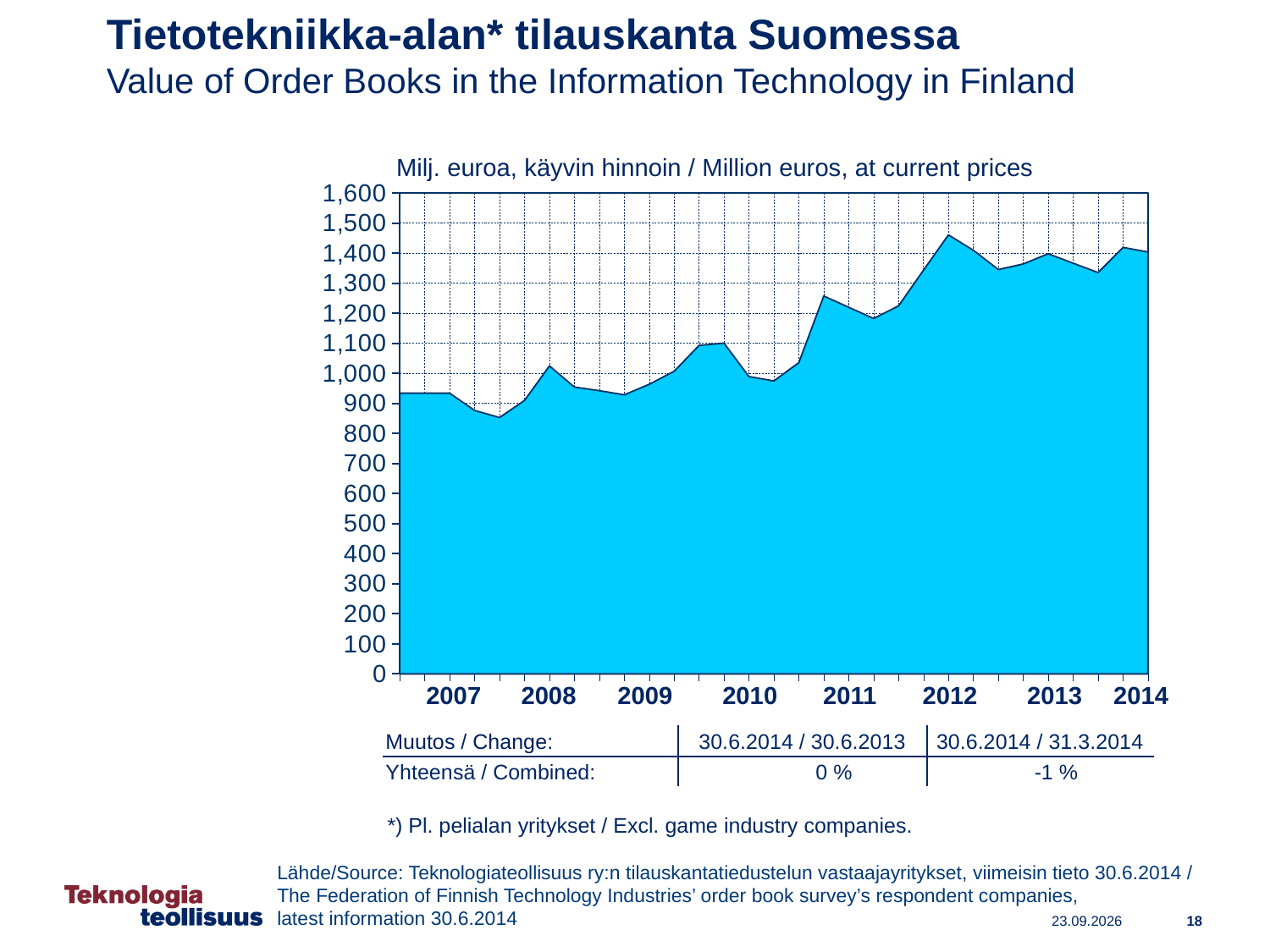
How many years are labelled on the x axis of the chart? 8 Is the lowest value in the chart, reached in late 2007, greater or less than 900? less What kind of chart is shown on the slide? area chart Is the value at the start of 2013 greater or less than 1,300? greater Is the value in 2012 higher or lower than the value in 2007? higher Which year is the first labelled on the x axis? 2007 Is the value at the start of 2010 greater or less than 900? greater What is the highest value shown on the y axis of the chart? 1,600 Overall, do the values rise or fall from 2007 to 2014? rise